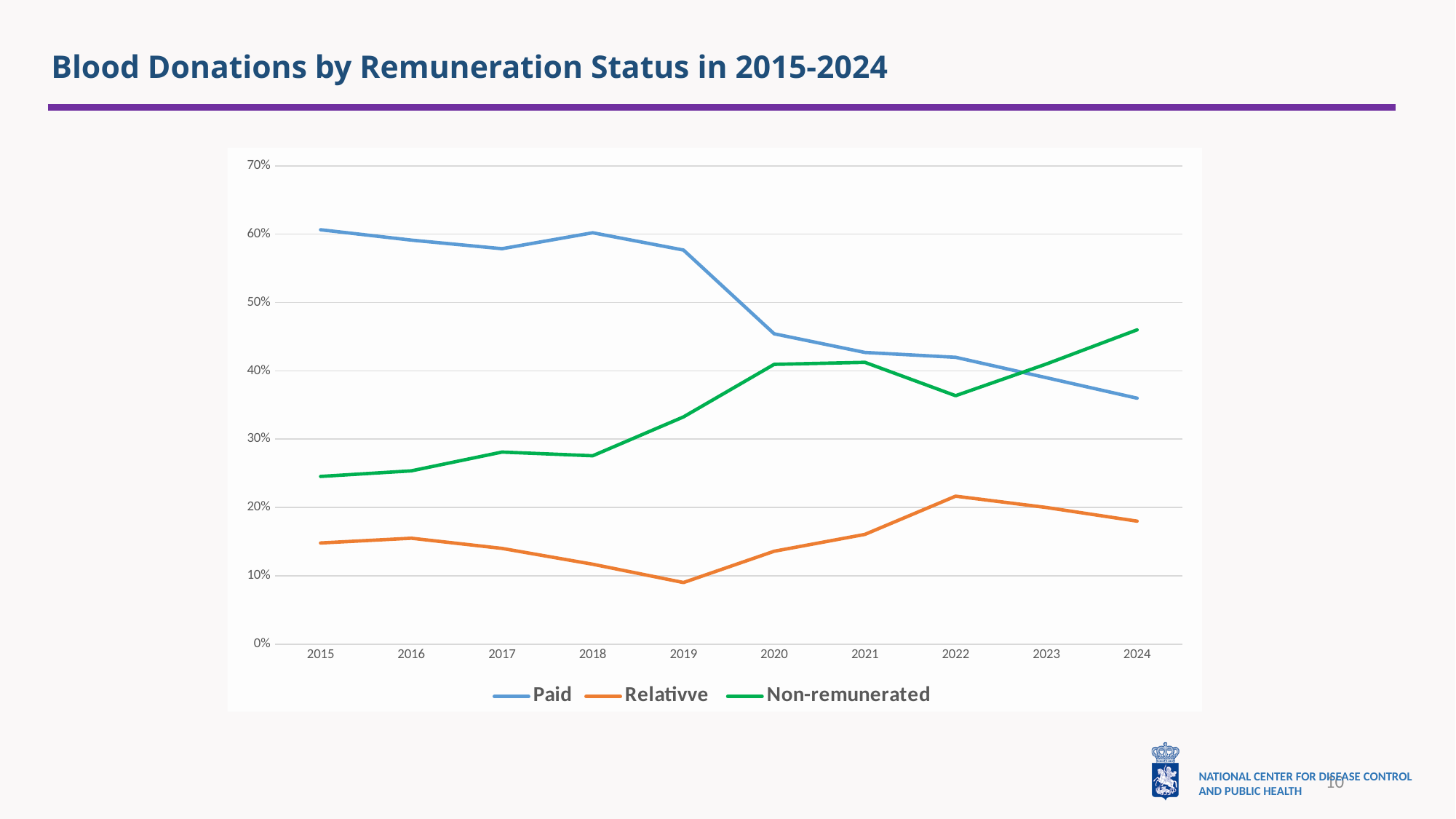
What is the title of the slide? Blood Donations by Remuneration Status in 2015-2024 In which year does the Relativve series reach its lowest value? 2019 In 2024, which series has the higher value, Paid or Non-remunerated? Non-remunerated Is the value for Paid in 2019 greater or less than 50%? greater How many series does the legend list? 3 In which year does the Non-remunerated series reach its highest value? 2024 Is the value for Non-remunerated in 2024 greater or less than 40%? greater Is the value for Relativve in 2019 greater or less than 10%? less What kind of chart is shown on the slide? Line chart How many years are plotted along the x axis? 10 Does the Paid series generally rise or fall from 2015 to 2024? Fall